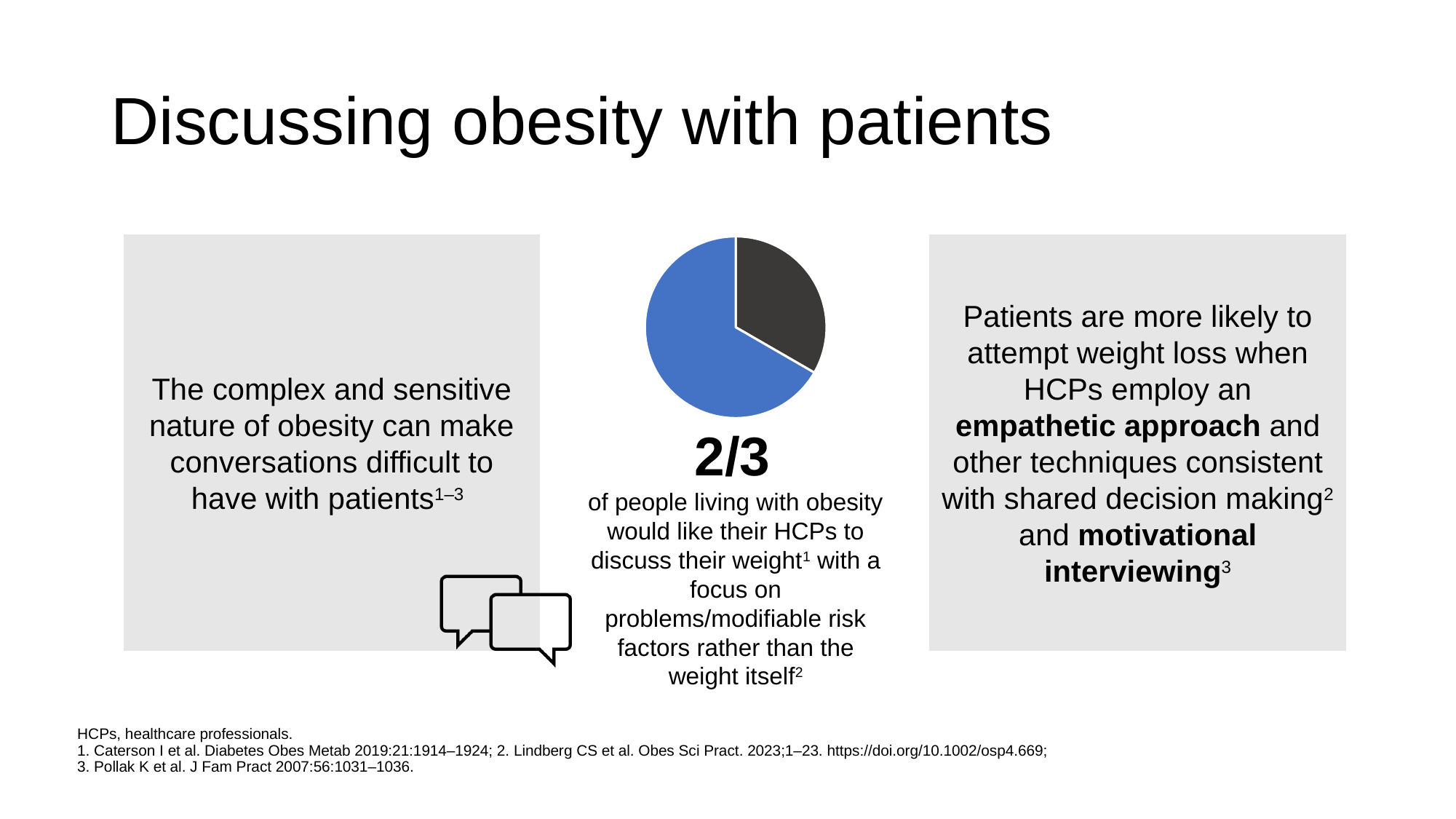
What kind of chart is shown in the middle of the slide? pie chart Is the blue slice of the pie chart greater or less than half of the pie? greater How many slices does the pie chart have? 2 Is the dark grey slice of the pie chart greater or less than half of the pie? less What colour is the larger slice of the pie chart? blue What fraction is printed in large bold text directly below the pie chart? 2/3 What share of the pie chart does the blue slice represent, as printed on the slide? 2/3 Does the pie chart have a legend? No Which slice of the pie chart is the smallest? the dark grey slice Which slice of the pie chart is larger, the blue slice or the dark grey slice? blue